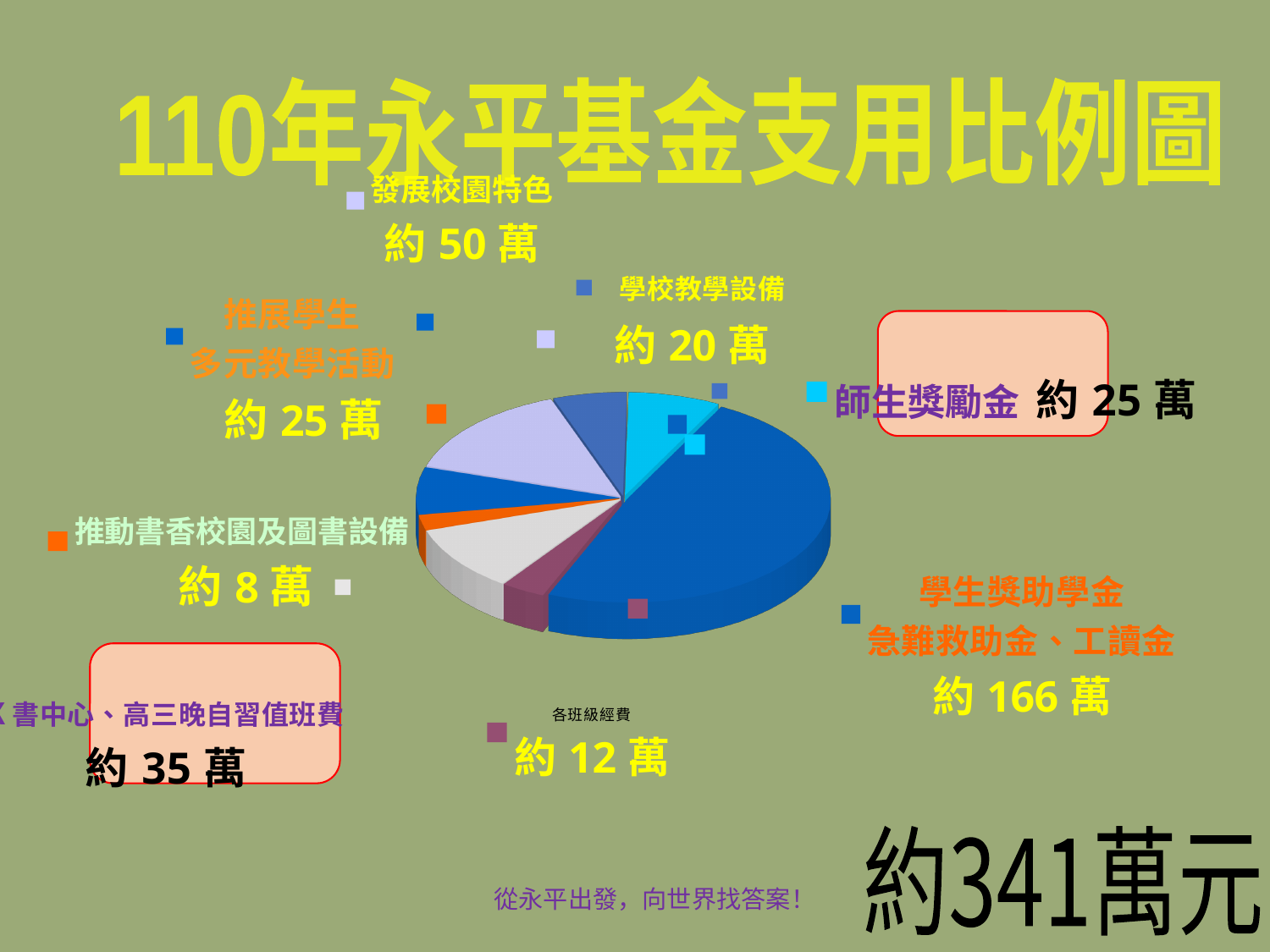
What amount is shown for 發展校園特色? 約 50 萬 What amount is shown for 學校教學設備? 約 20 萬 What amount is shown for 推動書香校園及圖書設備? 約 8 萬 What amount is shown for 師生獎勵金? 約 25 萬 Which category has the largest amount? 學生獎助學金 急難救助金、工讀金 What amount is shown for 各班級經費? 約 12 萬 How many categories does the pie chart have? 8 What is the total amount shown on the slide? 約341萬元 What is the title of the chart? 110年永平基金支用比例圖 Which is larger, 發展校園特色 or 學校教學設備? 發展校園特色 What kind of chart is shown on the slide? pie chart Which category has the smallest amount? 推動書香校園及圖書設備